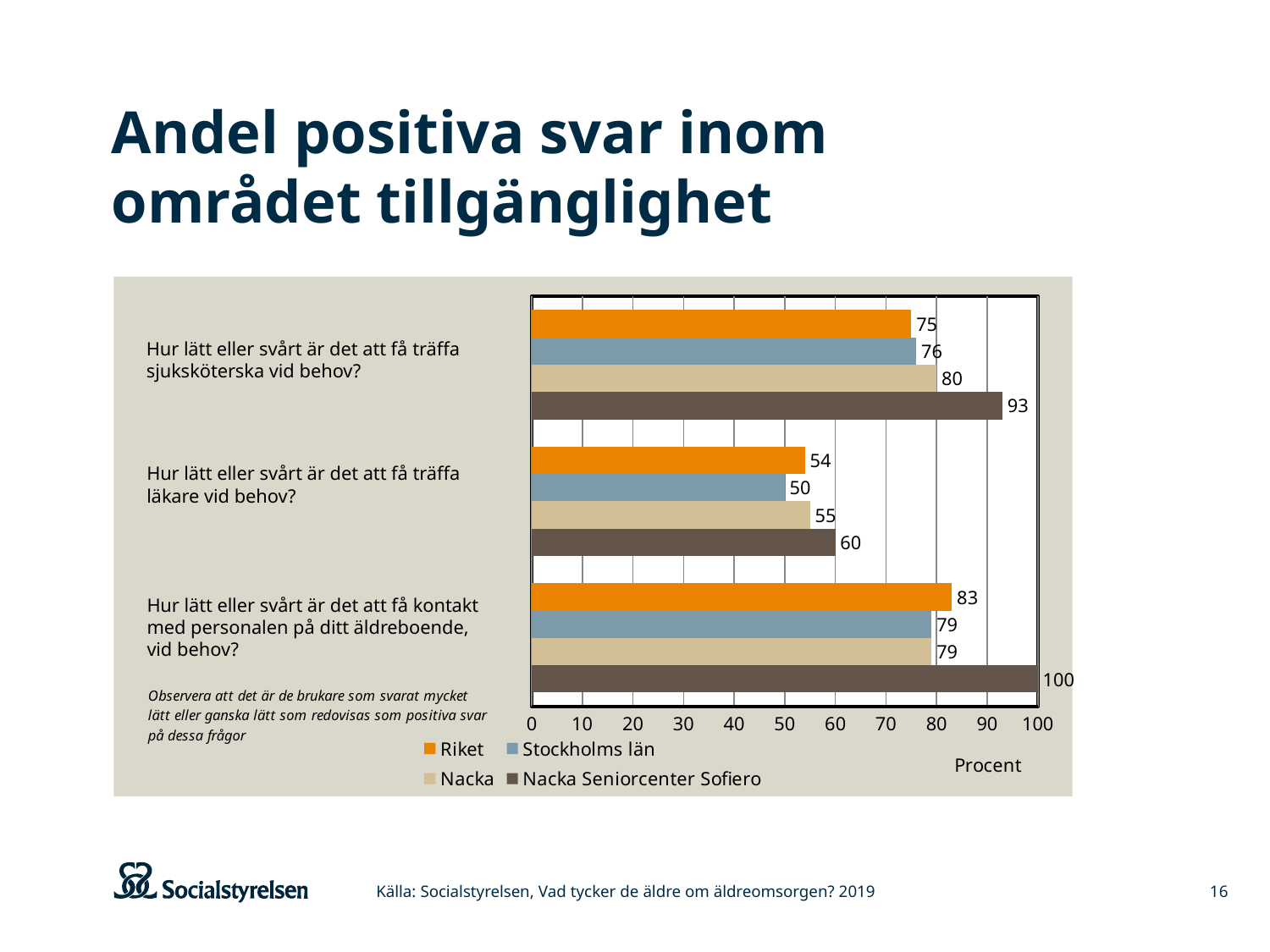
What is the difference between Nacka Seniorcenter Sofiero and Riket on "Hur lätt eller svårt är det att få kontakt med personalen på ditt äldreboende, vid behov?"? 17 What is the label on the horizontal axis of the chart? Procent Is the value for Nacka Seniorcenter Sofiero on "Hur lätt eller svårt är det att få träffa sjuksköterska vid behov?" greater or less than 90? greater What is the value for Riket on "Hur lätt eller svårt är det att få träffa läkare vid behov?"? 54 What kind of chart is shown on the slide? bar chart What is the value for Nacka Seniorcenter Sofiero on "Hur lätt eller svårt är det att få träffa sjuksköterska vid behov?"? 93 Which is larger on "Hur lätt eller svårt är det att få träffa sjuksköterska vid behov?": Nacka or Stockholms län? Nacka Which series has the highest value on "Hur lätt eller svårt är det att få träffa läkare vid behov?"? Nacka Seniorcenter Sofiero How many series does the legend list? 4 How many question categories are shown in the chart? 3 What is the value for Stockholms län on "Hur lätt eller svårt är det att få kontakt med personalen på ditt äldreboende, vid behov?"? 79 Which series has the lowest value on "Hur lätt eller svårt är det att få träffa läkare vid behov?"? Stockholms län